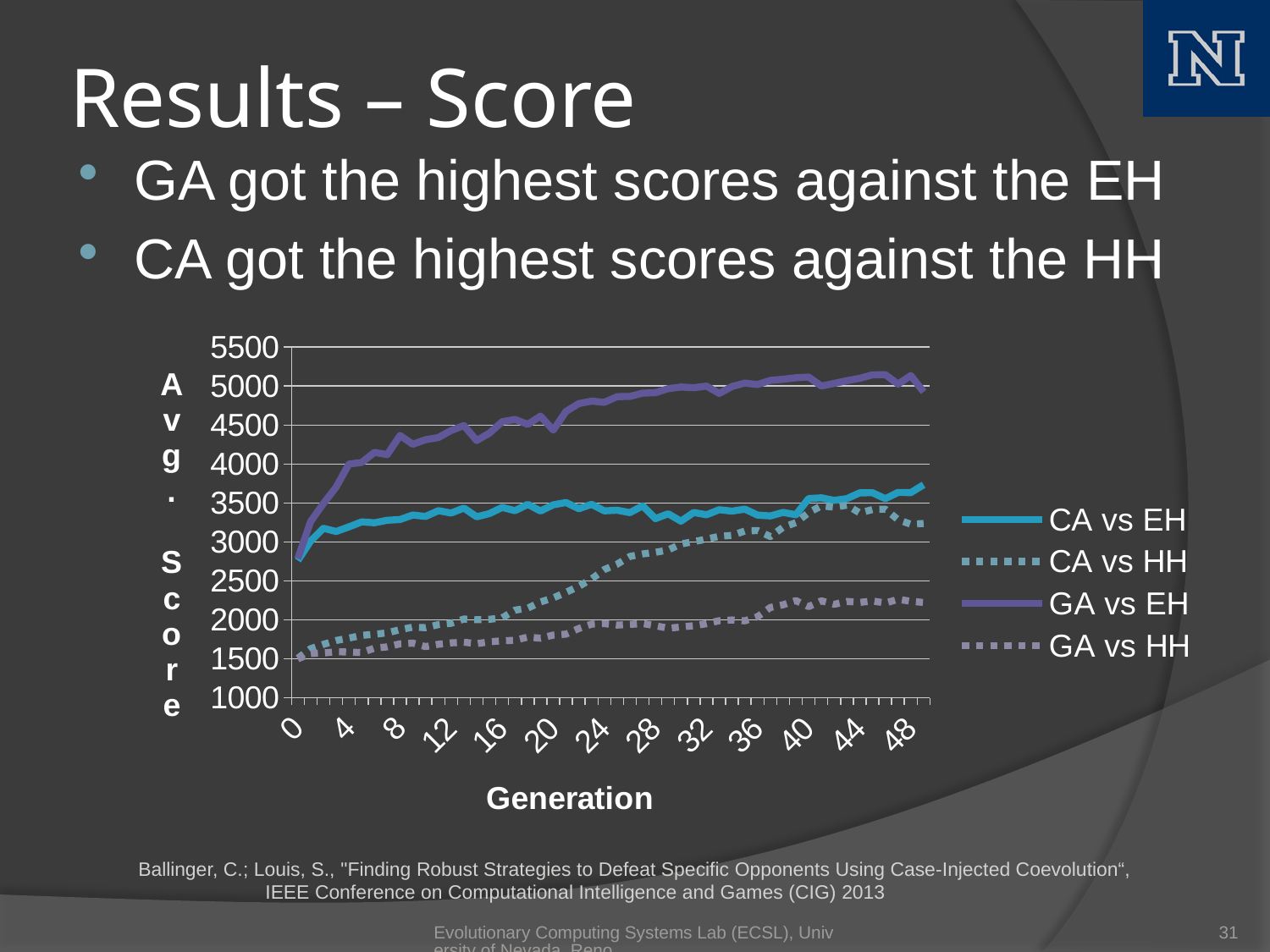
Is the value for CA vs HH at generation 40 greater or less than 3000? greater What is the title of the chart's x axis? Generation Do the values for GA vs EH generally rise or fall as the generation increases? rise Is the value for CA vs EH at generation 0 greater or less than 3000? less How many series does the chart's legend list? 4 At generation 24, which series has the higher value, GA vs EH or CA vs EH? GA vs EH What are the series names listed in the chart's legend? CA vs EH, CA vs HH, GA vs EH, GA vs HH Is the value for GA vs HH at generation 0 greater or less than 2000? less Do the values for CA vs HH generally rise or fall as the generation increases? rise What kind of chart is shown on the slide? line chart Which series has the highest value at generation 48? GA vs EH